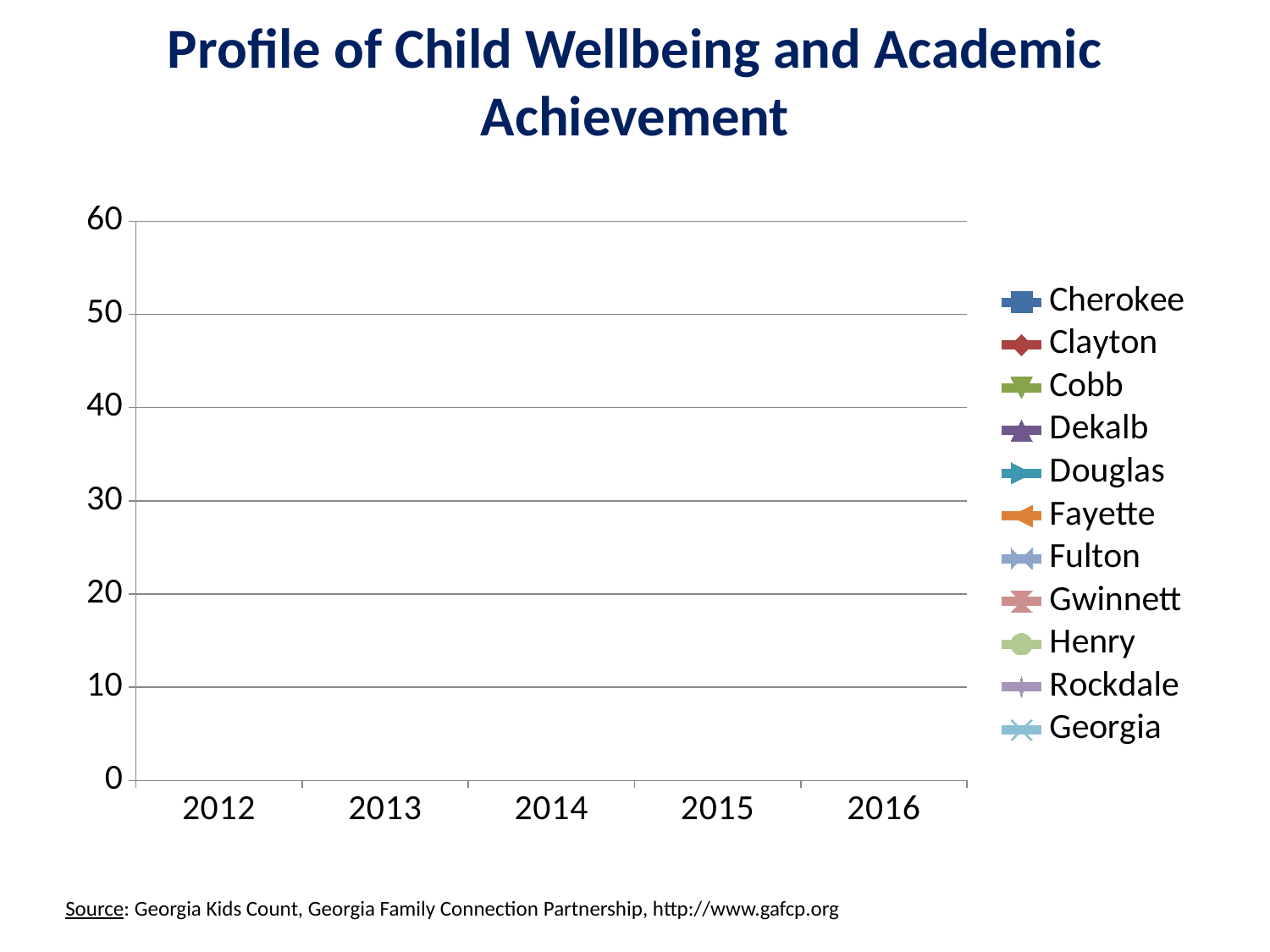
What is the last year shown on the x axis? 2016 What is the title of the chart? Profile of Child Wellbeing and Academic Achievement What kind of chart is this? line chart What is the highest value shown on the y axis? 60 What is the last series listed in the legend? Georgia How many series does the legend list? 11 How many years are shown on the x axis? 5 What is the first year shown on the x axis? 2012